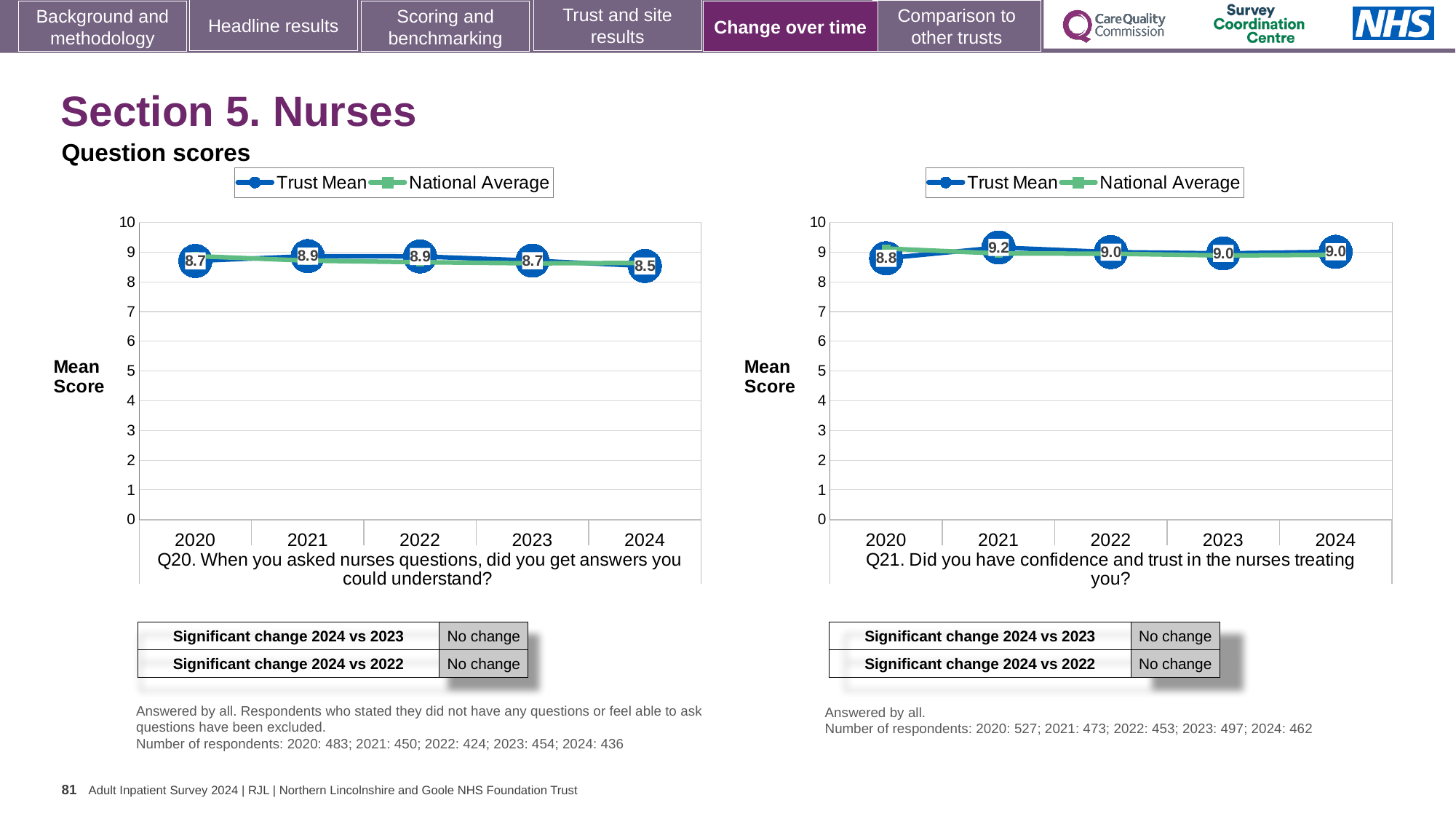
In the Q20 chart on the left, does the Trust Mean score rise or fall from 2022 to 2024? fall In the Q20 chart on the left, what is the difference between the Trust Mean scores for 2021 and 2024? 0.4 How many series does the legend of the Q20 chart on the left list? 2 In the Q21 chart on the right, which year has the lowest Trust Mean score? 2020 In the Q21 chart on the right, which year has the highest Trust Mean score? 2021 In the Q21 chart on the right, what is the difference between the Trust Mean scores for 2021 and 2020? 0.4 How many years are plotted on the x axis of the Q21 chart on the right? 5 In the Q20 chart on the left, is the National Average value for 2024 greater or less than 8? greater In the Q20 chart on the left, what is the Trust Mean score for 2024? 8.5 In the Q20 chart on the left, which year has the lowest Trust Mean score? 2024 In the Q21 chart on the right, what is the Trust Mean score for 2021? 9.2 In the Q20 chart on the left, is the Trust Mean score higher in 2022 or in 2024? 2022